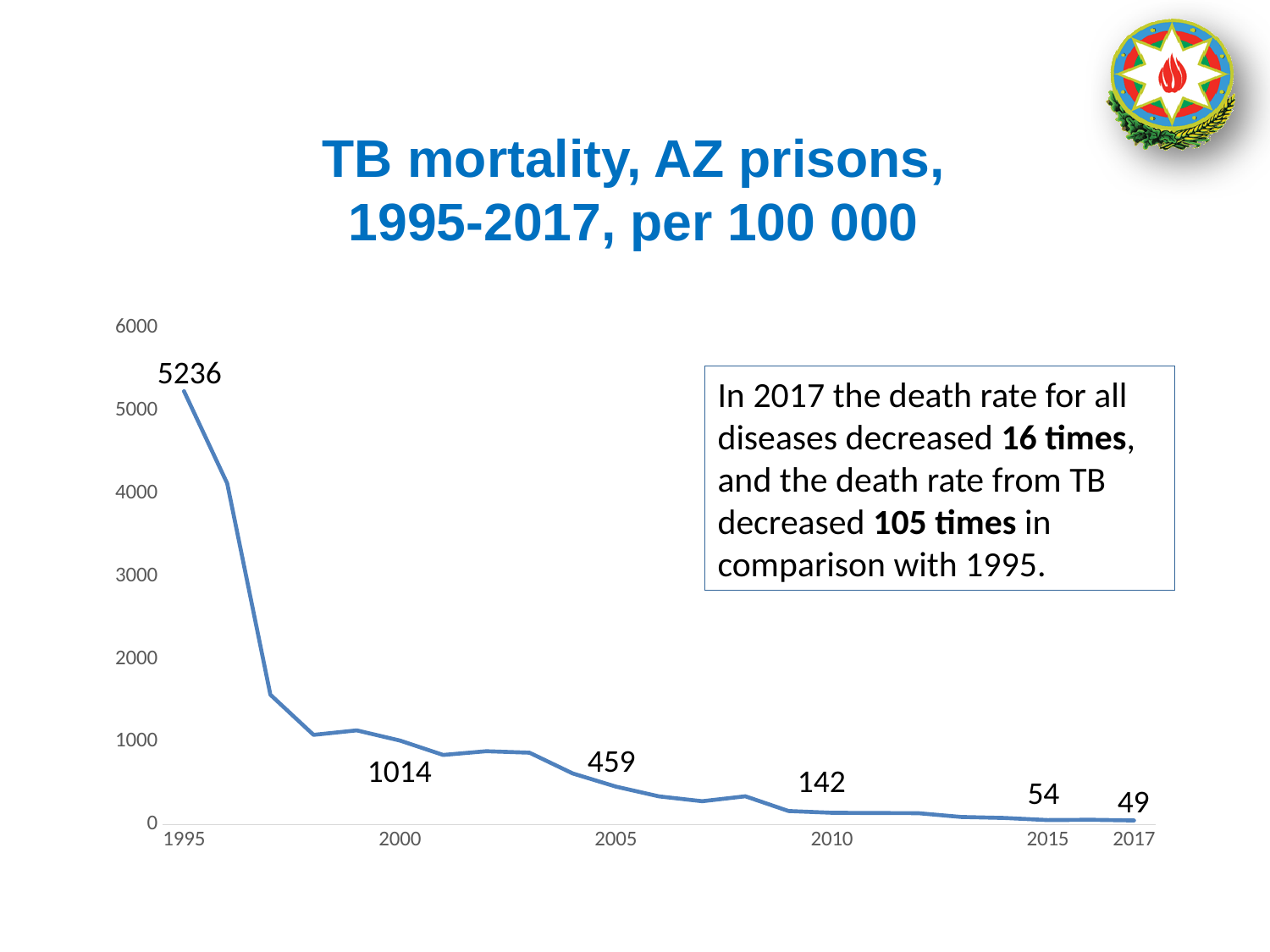
What is the TB mortality value for 2000? 1014 What is the TB mortality value for 2010? 142 What is the TB mortality value for 1995? 5236 Which labeled year has the lowest TB mortality value? 2017 Which labeled year has the highest TB mortality value? 1995 Do the values rise or fall from 1995 to 2017? fall What kind of chart is shown on the slide? line chart What is the TB mortality value for 2017? 49 Which is larger, the value for 2005 or the value for 2010? 2005 What is the TB mortality value for 2005? 459 What is the difference between the TB mortality values for 1995 and 2017? 5187